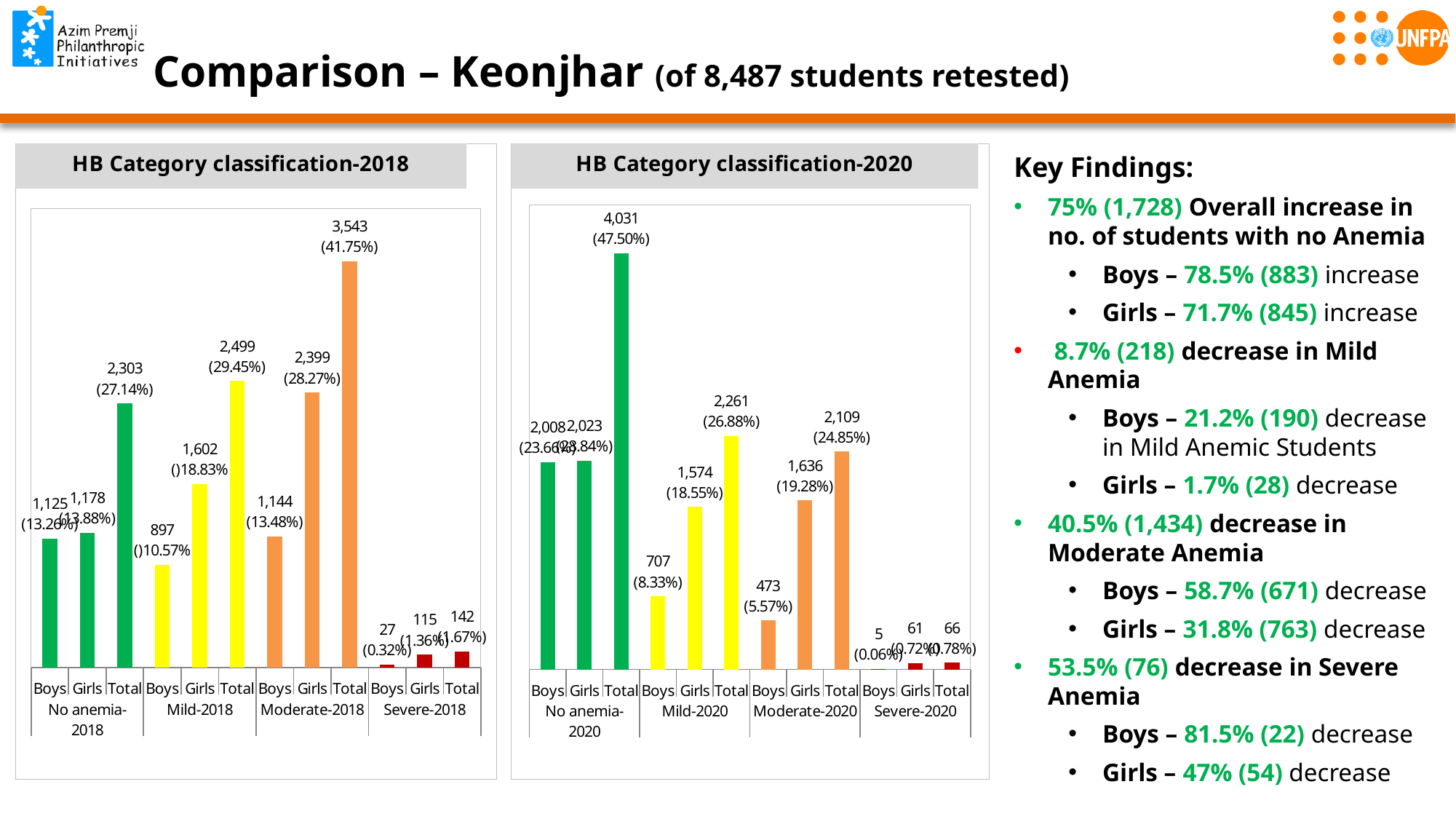
In the HB Category classification-2018 chart, which is larger: Girls under Moderate-2018 or Girls under Mild-2018? Girls under Moderate-2018 What type of chart is the HB Category classification-2018 chart? Bar chart In the HB Category classification-2020 chart, what is the value for Total under No anemia-2020? 4,031 How many bars are plotted in the HB Category classification-2020 chart? 12 In the HB Category classification-2018 chart, which bar has the highest value? Total, Moderate-2018 In the HB Category classification-2018 chart, what is the difference between the Total and Boys values under Severe-2018? 115 In the HB Category classification-2020 chart, what is the difference between the Girls and Boys values under Mild-2020? 867 In the HB Category classification-2020 chart, what percentage is shown for Total under Severe-2020? 0.78% In the HB Category classification-2020 chart, what is the value for Boys under Moderate-2020? 473 In the HB Category classification-2020 chart, which bar has the lowest value? Boys, Severe-2020 In the HB Category classification-2018 chart, what percentage is shown for Girls under Mild-2018? 18.83% In the HB Category classification-2018 chart, what is the value for Total under Moderate-2018? 3,543